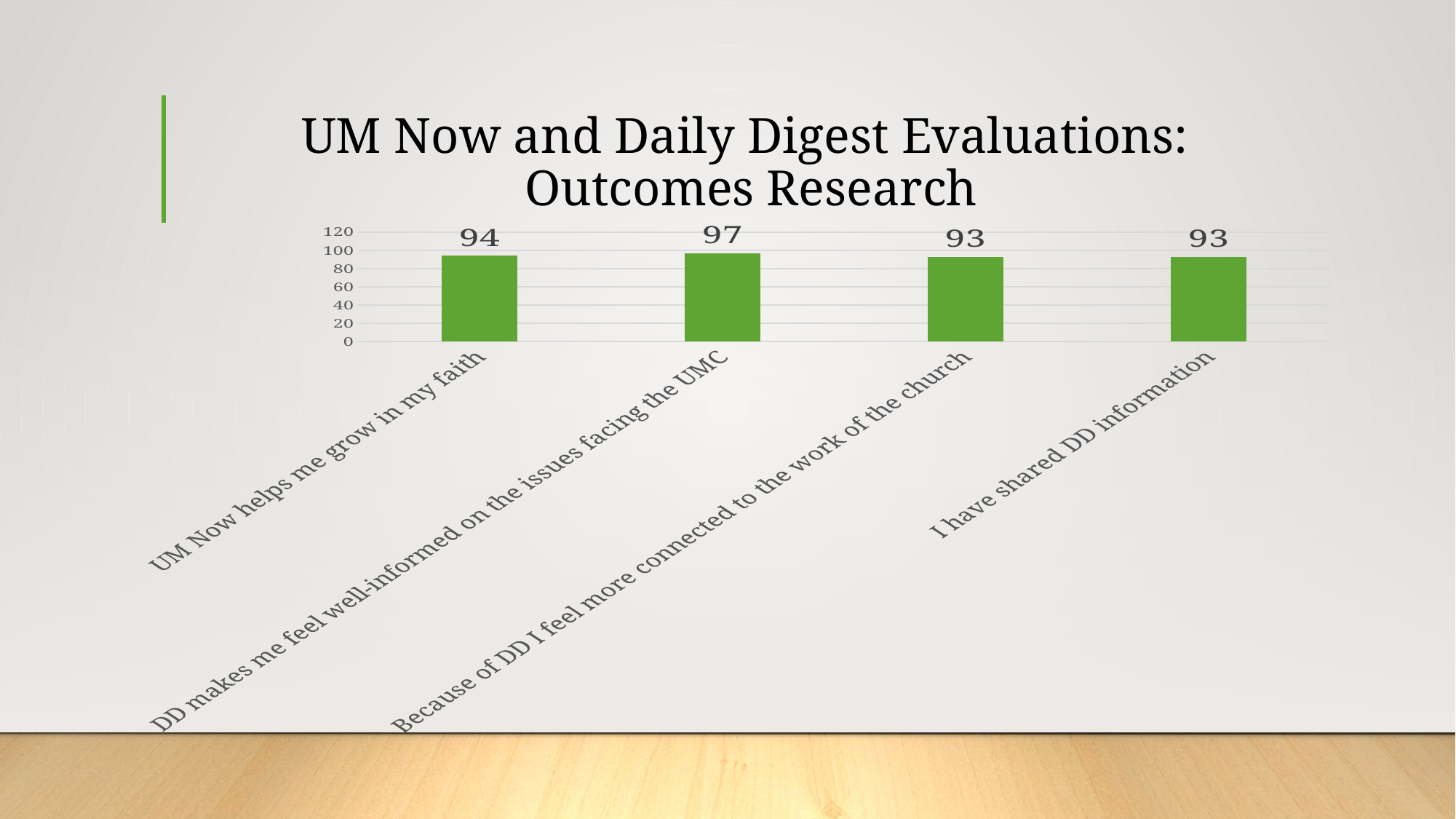
Is the value for "DD makes me feel well-informed on the issues facing the UMC" greater or less than 80? greater What is the difference between the values for "DD makes me feel well-informed on the issues facing the UMC" and "I have shared DD information"? 4 How many categories are shown in the chart? 4 What is the difference between the values for "DD makes me feel well-informed on the issues facing the UMC" and "UM Now helps me grow in my faith"? 3 Which is larger: the value for "UM Now helps me grow in my faith" or the value for "I have shared DD information"? UM Now helps me grow in my faith Which category has the highest value? DD makes me feel well-informed on the issues facing the UMC What is the value for "Because of DD I feel more connected to the work of the church"? 93 What is the highest value shown on the vertical axis? 120 What is the value for "UM Now helps me grow in my faith"? 94 What kind of chart is shown on the slide? bar chart What is the value for "DD makes me feel well-informed on the issues facing the UMC"? 97 What is the value for "I have shared DD information"? 93